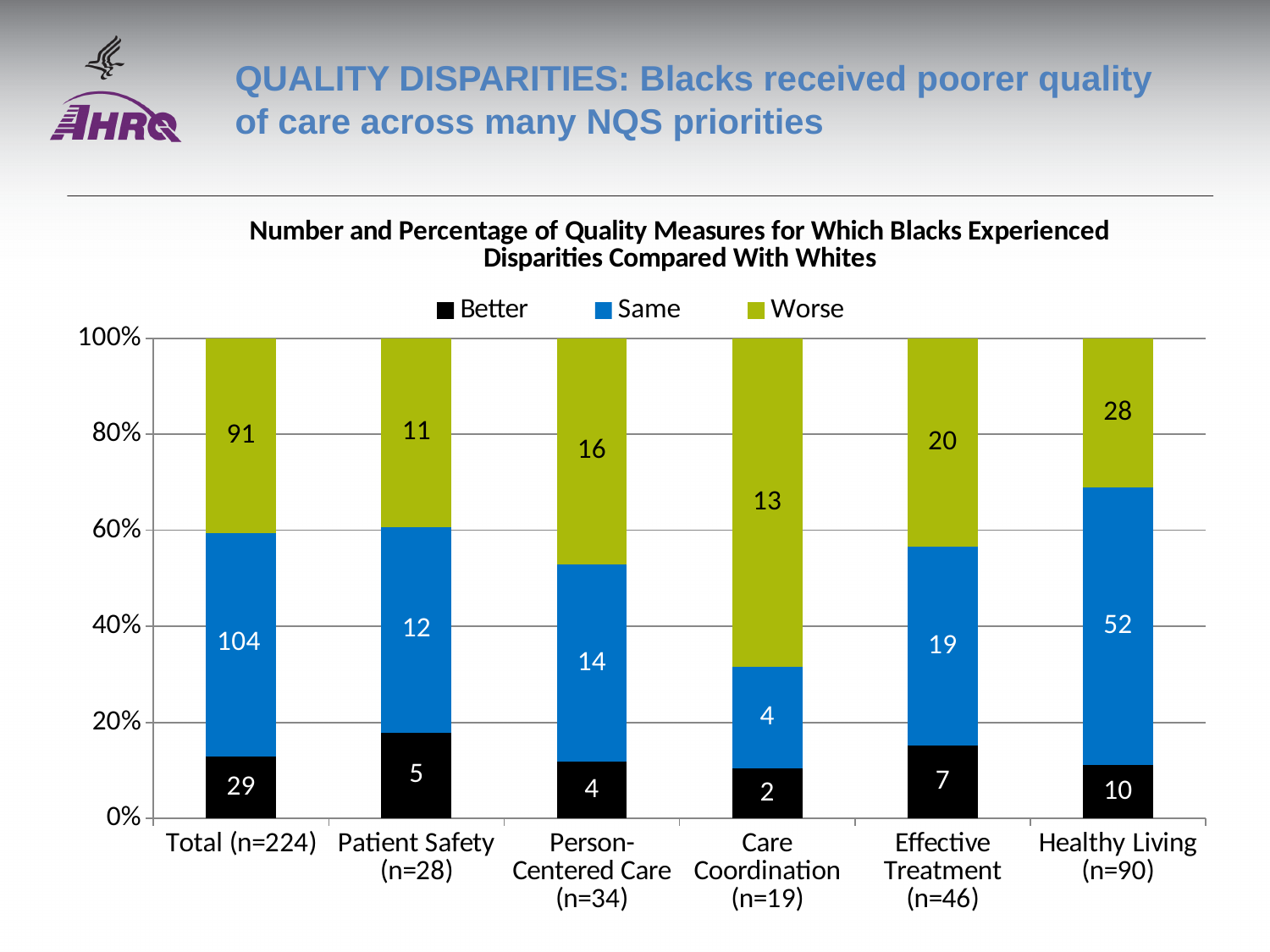
How many series does the legend list? 3 Which category has the highest Worse value? Total (n=224) How many categories are shown on the x axis? 6 What is the Better value for Effective Treatment (n=46)? 7 What is the total of the Better, Same and Worse values for Patient Safety (n=28)? 28 What is the difference between the Same and Worse values for Total (n=224)? 13 What is the Same value for Healthy Living (n=90)? 52 Which category has the lowest Better value? Care Coordination (n=19) What kind of chart is shown on the slide? Stacked bar chart Which is larger for Person-Centered Care (n=34): the Same value or the Worse value? Worse What is the Worse value for Care Coordination (n=19)? 13 Is the Worse share of the Care Coordination (n=19) bar greater or less than 60%? greater